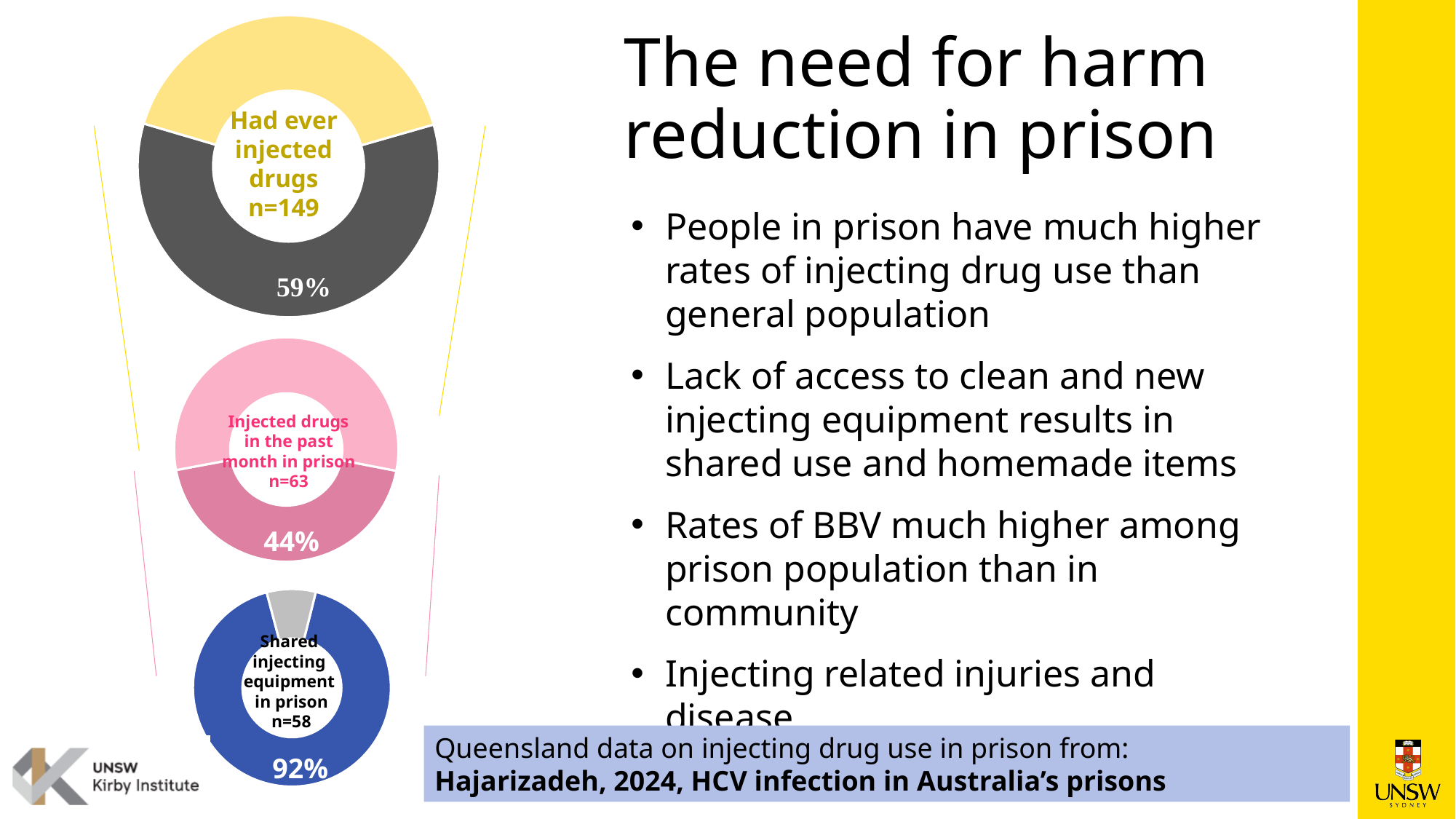
What is the sample size (n) shown in the middle doughnut chart, 'Injected drugs in the past month in prison'? n=63 What is the sample size (n) shown in the bottom doughnut chart, 'Shared injecting equipment in prison'? n=58 Which of the three doughnut charts shows the lowest percentage? Injected drugs in the past month in prison (44%) Which is larger: the percentage in the top chart (Had ever injected drugs) or the percentage in the middle chart (Injected drugs in the past month in prison)? Had ever injected drugs (59%) What type of chart is used on the left side of the slide to show the percentages? Doughnut (pie) chart What is the sample size (n) shown in the top doughnut chart, 'Had ever injected drugs'? n=149 In the bottom doughnut chart labelled 'Shared injecting equipment in prison', what percentage is shown? 92% How many doughnut charts are shown on the slide? 3 In the top doughnut chart labelled 'Had ever injected drugs', what percentage is shown? 59% Which of the three doughnut charts shows the highest percentage? Shared injecting equipment in prison (92%) In the middle doughnut chart labelled 'Injected drugs in the past month in prison', what percentage is shown? 44% What is the difference in percentage points between the bottom chart (Shared injecting equipment in prison) and the top chart (Had ever injected drugs)? 33 percentage points